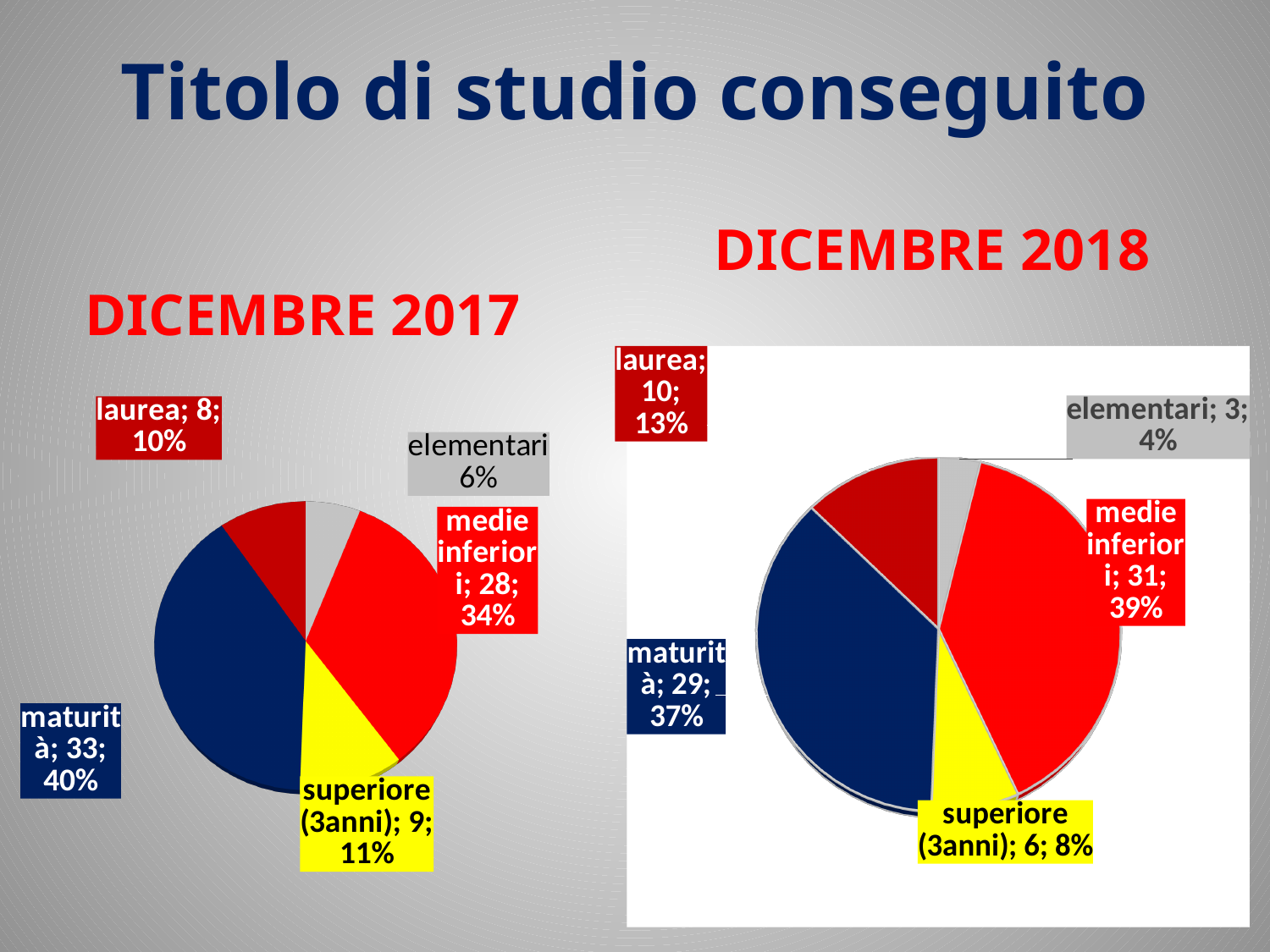
What type of chart is used for DICEMBRE 2017? pie chart In the DICEMBRE 2018 pie chart, which category has the largest slice? medie inferiori In the DICEMBRE 2017 pie chart, what is the value for maturità? 33 In the DICEMBRE 2018 pie chart, what is the value for laurea? 10 How many categories does the DICEMBRE 2018 pie chart show? 5 In the DICEMBRE 2017 pie chart, which category has the largest slice? maturità In the DICEMBRE 2018 pie chart, which category has the smallest slice? elementari In the DICEMBRE 2018 pie chart, which is larger, the value for superiore (3anni) or the value for laurea? laurea In the DICEMBRE 2017 pie chart, what is the difference between the values for maturità and medie inferiori? 5 In the DICEMBRE 2018 pie chart, what percentage share does maturità have? 37% In the DICEMBRE 2017 pie chart, what percentage share does elementari have? 6% In the DICEMBRE 2017 pie chart, what percentage share does medie inferiori have? 34%